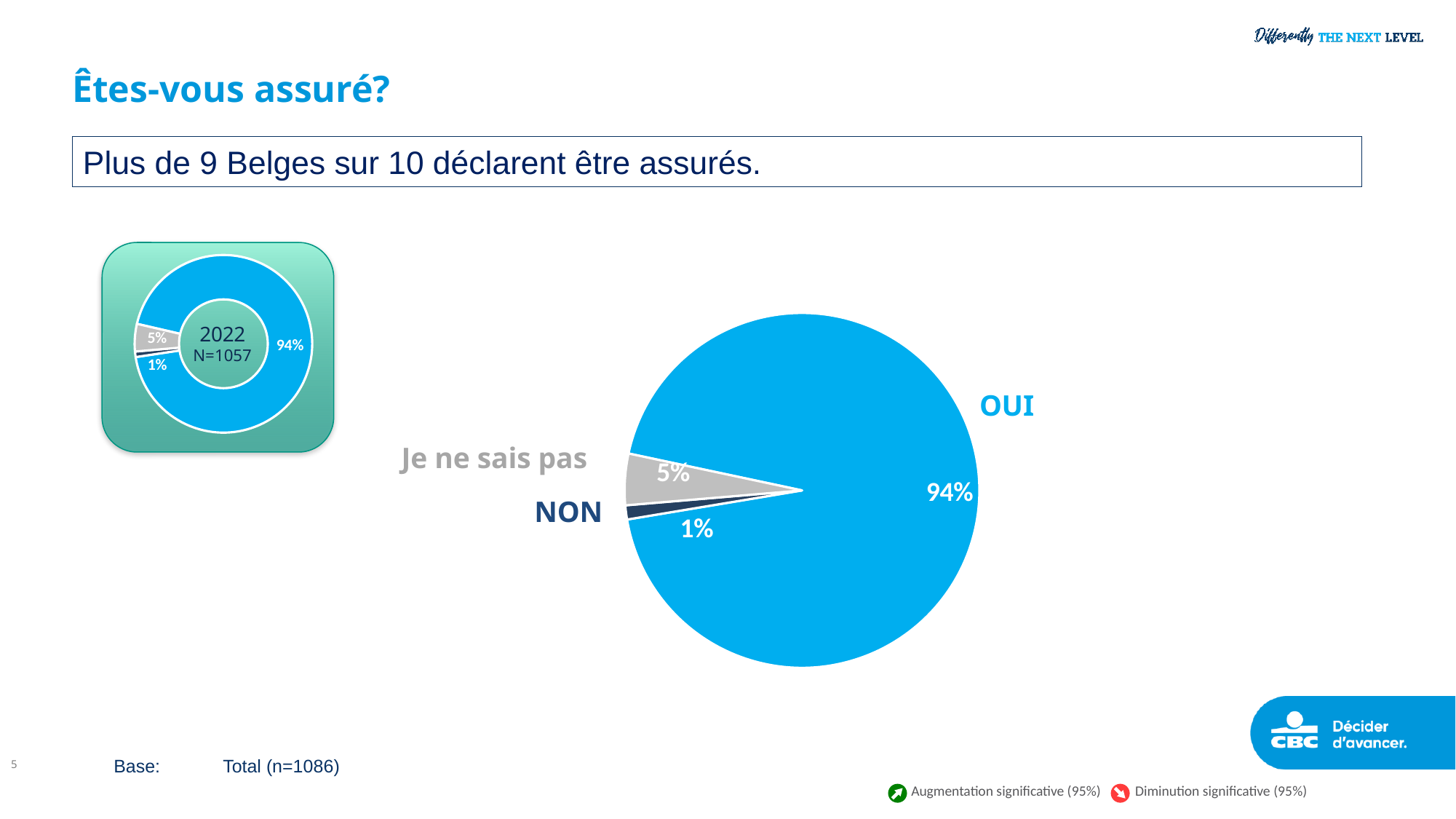
On the large pie chart, what is the difference between the OUI share and the 'Je ne sais pas' share? 89% On the large pie chart, what share of respondents answered OUI? 94% How many slices does the large pie chart have? 3 What kind of chart is the small chart on the left of the slide? Donut chart On the large pie chart, which category has the smallest slice? NON On the large pie chart, what share of respondents answered 'Je ne sais pas'? 5% On the small donut chart on the left, what year and sample size are shown in the centre? 2022, N=1057 On the large pie chart, which category has the largest slice? OUI What kind of chart is the large chart in the centre of the slide? Pie chart On the large pie chart, which is larger: the 'Je ne sais pas' slice or the NON slice? Je ne sais pas On the large pie chart, what share of respondents answered NON? 1% On the small donut chart on the left, what is the largest value shown? 94%